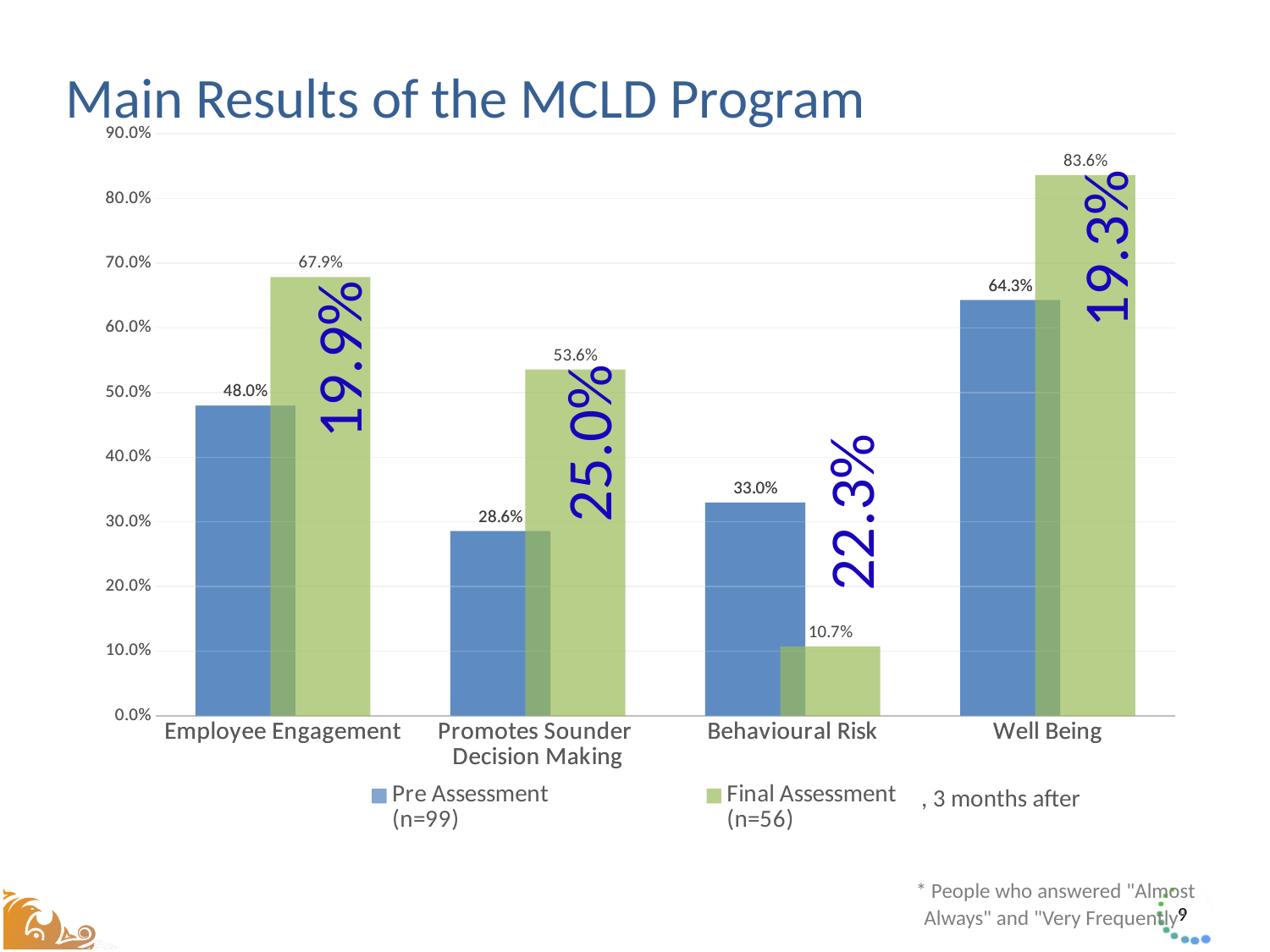
How many series does the legend list? 2 What is the Final Assessment value for Behavioural Risk? 10.7% Which category has the highest Pre Assessment value? Well Being How many categories are shown on the x axis? 4 What kind of chart is shown on the slide? Bar chart What is the Final Assessment value for Well Being? 83.6% For Employee Engagement, which is larger: the Pre Assessment value or the Final Assessment value? Final Assessment What is the difference between the Final Assessment and Pre Assessment values for Promotes Sounder Decision Making? 25.0% What is the sample size (n) given in the legend for the Pre Assessment series? n=99 Which category has the lowest Final Assessment value? Behavioural Risk What is the difference between the Pre Assessment and Final Assessment values for Behavioural Risk? 22.3% What is the Pre Assessment value for Promotes Sounder Decision Making? 28.6%